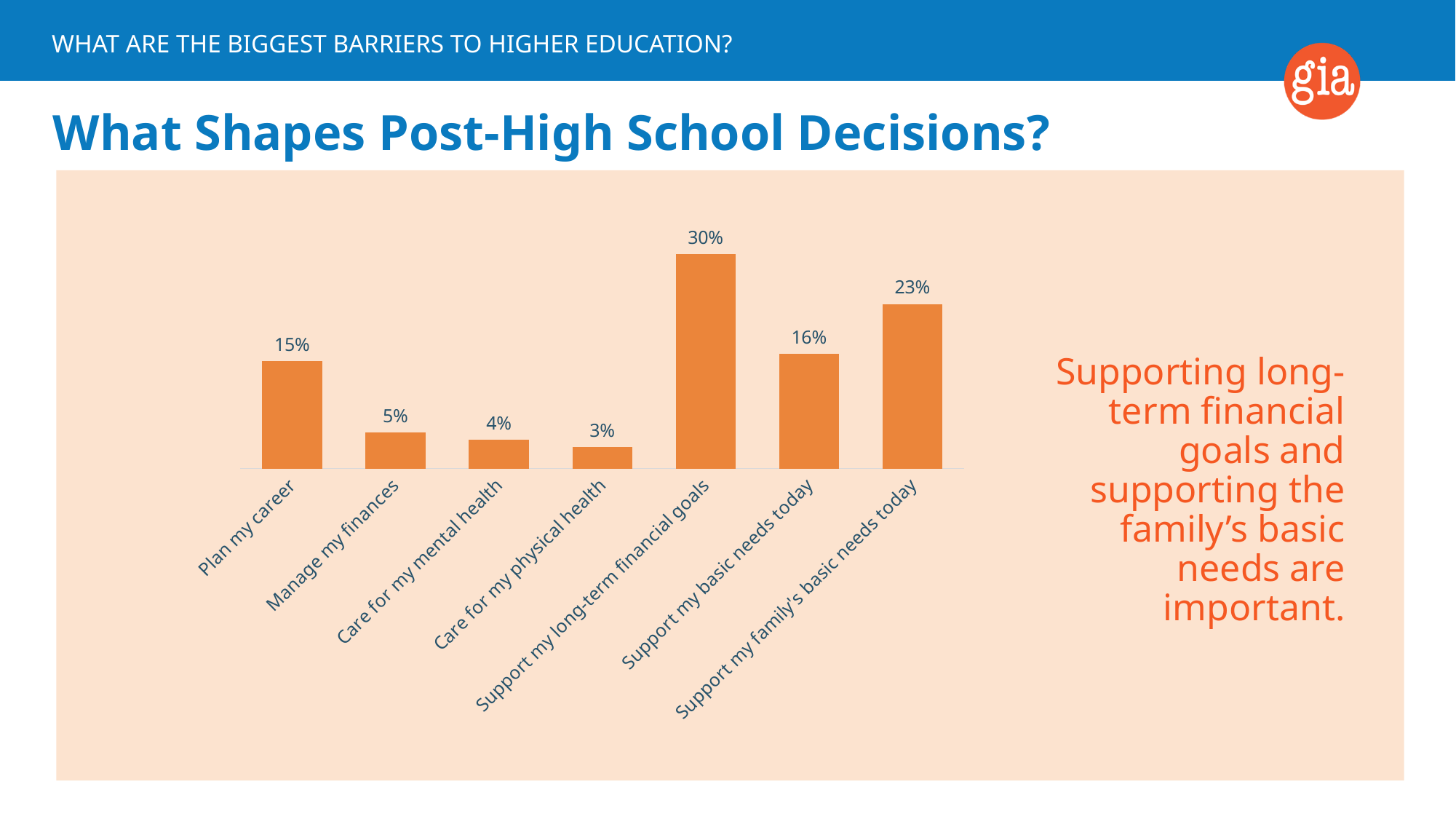
Which is larger, 'Manage my finances' or 'Care for my mental health'? Manage my finances What is the value for 'Support my family's basic needs today'? 23% How many categories are shown in the chart? 7 What is the value for 'Plan my career'? 15% What is the difference between 'Support my long-term financial goals' and 'Support my family's basic needs today'? 7% Which category has the lowest value? Care for my physical health What is the title of the slide above the chart? What Shapes Post-High School Decisions? What is the value for 'Support my long-term financial goals'? 30% What kind of chart is shown on the slide? Bar chart What is the value for 'Care for my physical health'? 3% What is the difference between 'Support my basic needs today' and 'Plan my career'? 1% Which category has the highest value? Support my long-term financial goals